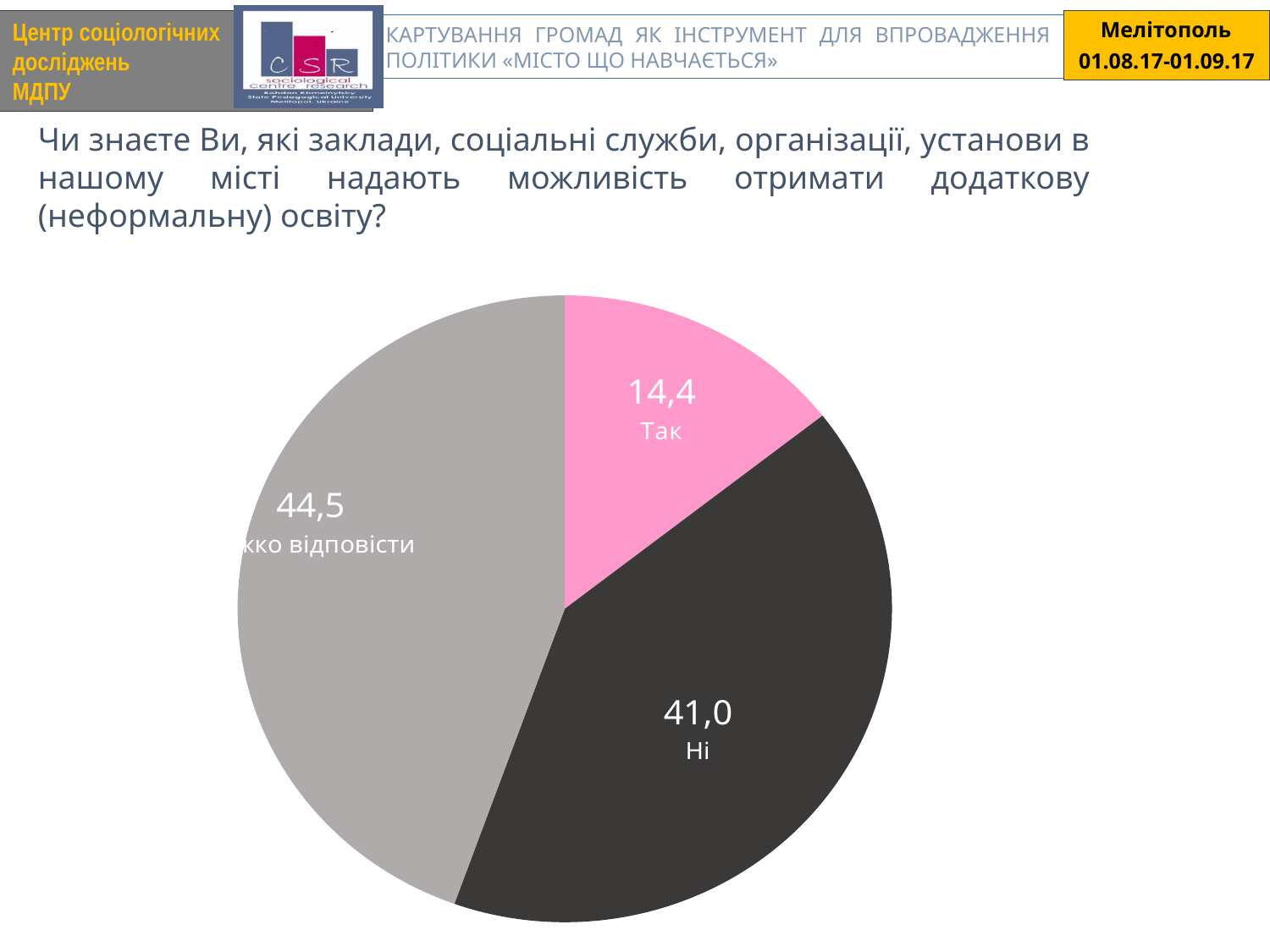
What is the difference between the value for "Ні" and the value for "Так"? 26,6 Which is larger, the value for "Ні" or the value for "Так"? Ні What is the value shown for the "Так" slice? 14,4 Which slice of the pie chart has the smallest value? Так What is the value shown for the light grey slice of the pie chart? 44,5 What is the difference between the light grey slice's value and the value for "Ні"? 3,5 What colour is the "Ні" slice of the pie chart? dark grey How many slices does the pie chart have? 3 What is the largest value shown on the pie chart? 44,5 What colour is the "Так" slice of the pie chart? pink What is the value shown for the "Ні" slice? 41,0 What kind of chart is shown on the slide? pie chart